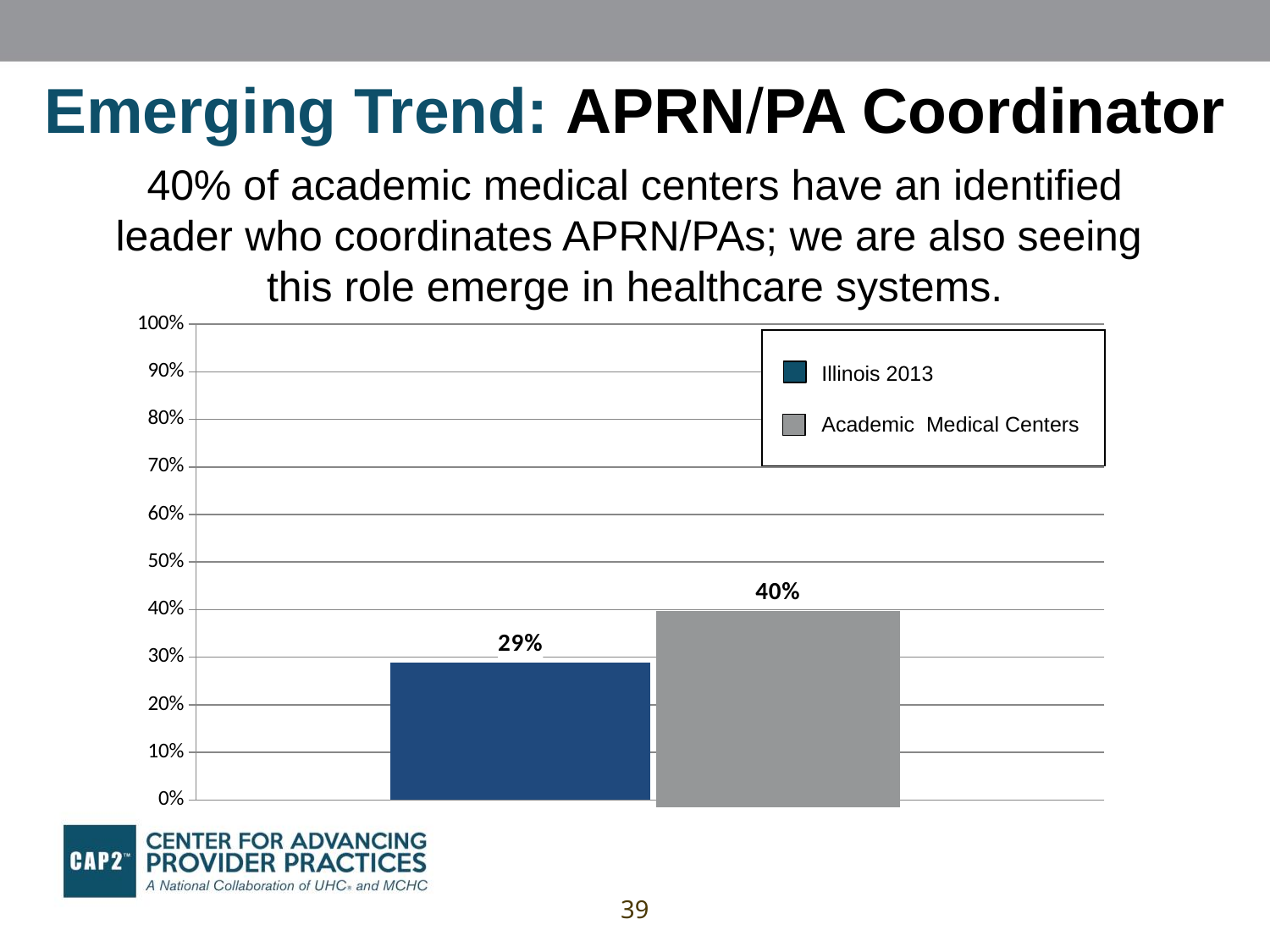
Is the value for Illinois 2013 greater or less than 30%? less What is the value for Illinois 2013? 29% Is the value for Academic Medical Centers greater or less than 50%? less What kind of chart is shown on the slide? Bar chart Which series has the lowest value? Illinois 2013 What colour is the bar for Illinois 2013? Blue What is the difference between the Academic Medical Centers value and the Illinois 2013 value? 11% Which series has the highest value? Academic Medical Centers What is the value for Academic Medical Centers? 40% How many series does the legend list? 2 Which series has the higher value, Illinois 2013 or Academic Medical Centers? Academic Medical Centers How many bars are plotted in the chart? 2